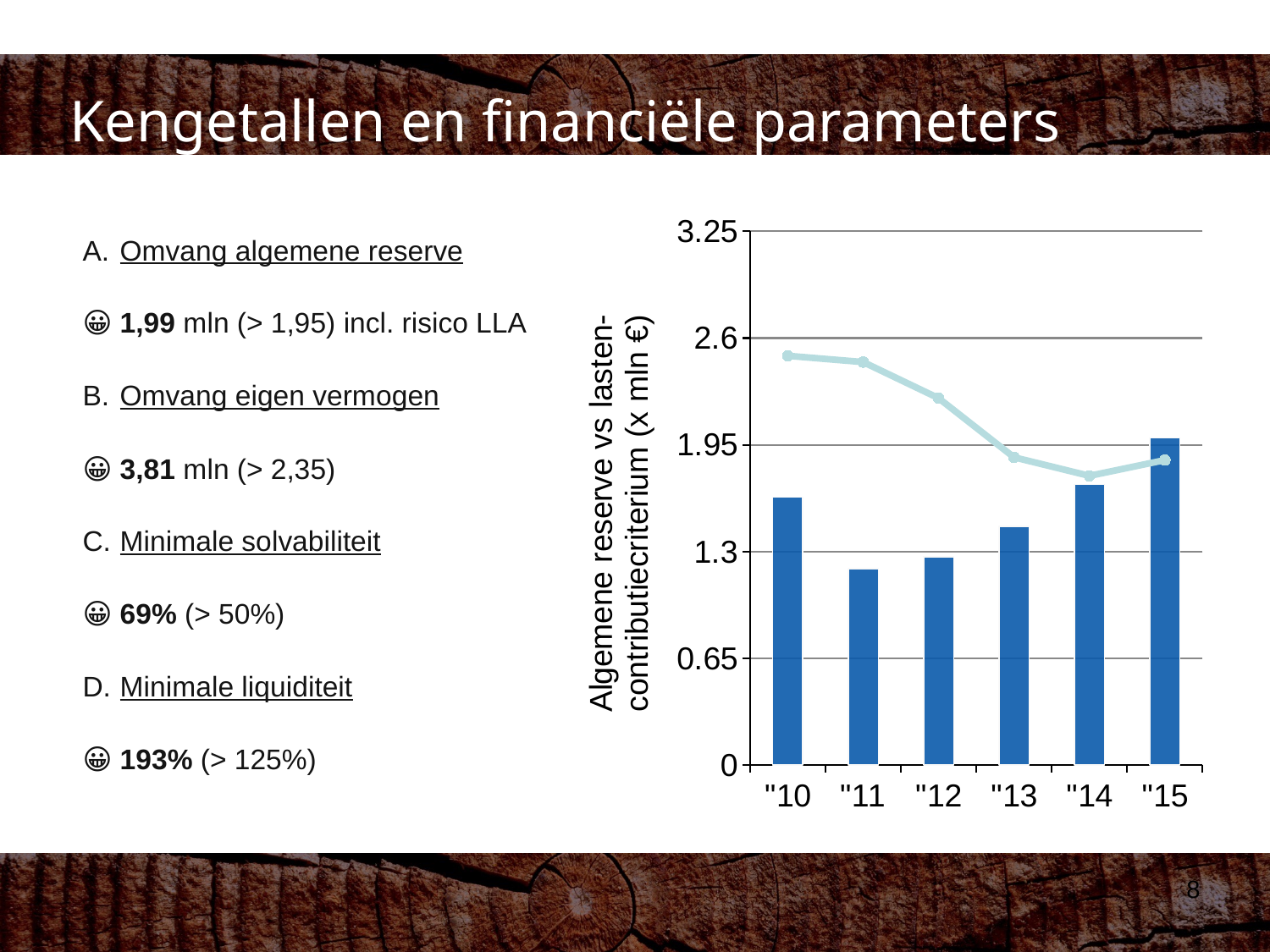
What is the title of the vertical axis of the chart? Algemene reserve vs lasten-contributiecriterium (x mln €) Is the bar value for "15 greater or less than 1.95? greater Is the bar value for "10 greater or less than 1.3? greater Is the line value for "10 greater or less than 2.6? less Which year has the tallest bar in the chart? "15 What kind of chart is shown on the slide? A bar chart combined with a line How many years are shown on the x axis of the chart? 6 Which year has the shortest bar in the chart? "11 Does the line rise or fall from "10 to "14? fall